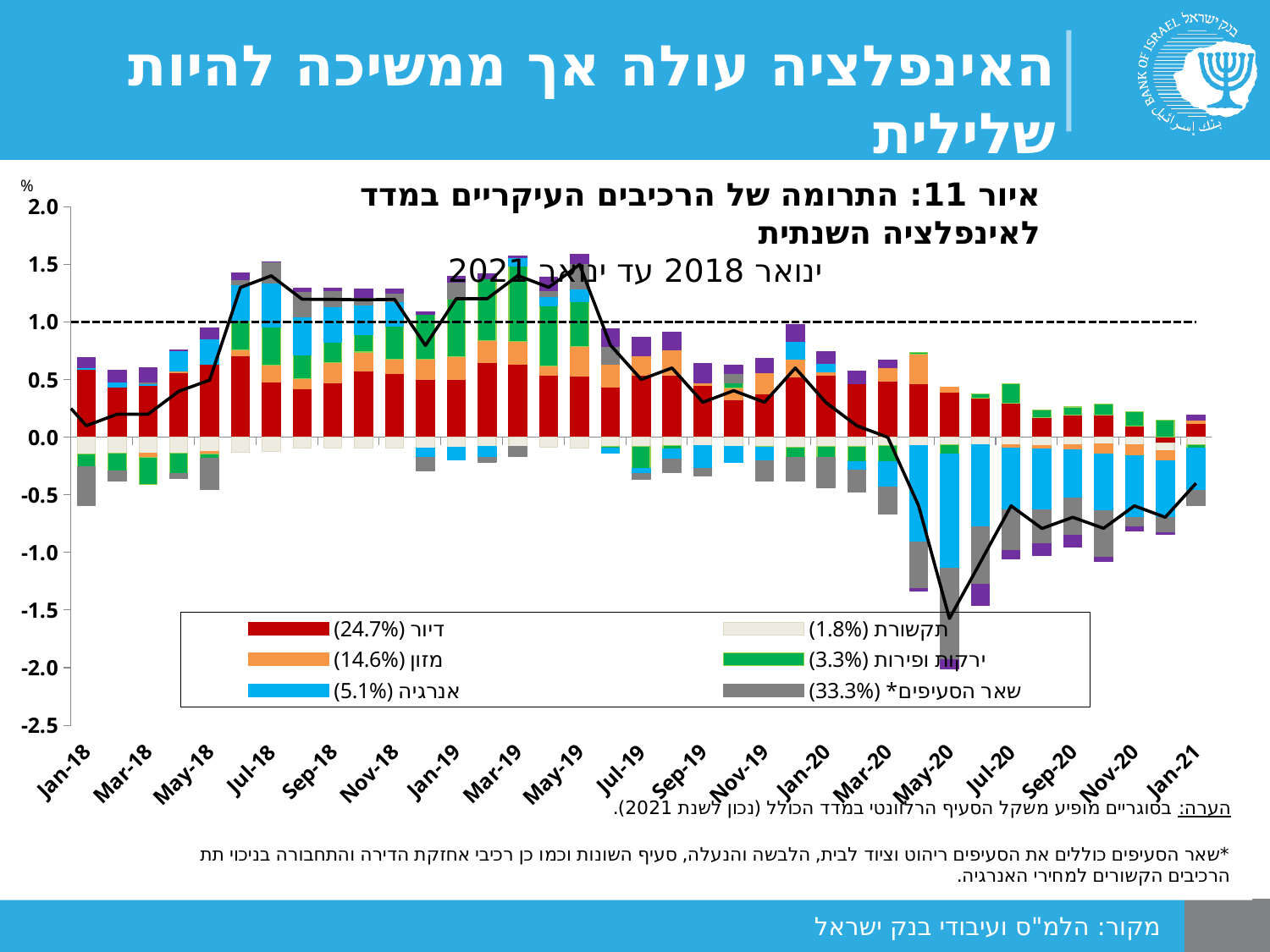
Is the value of the black line for Mar-19 greater or less than 1.0? greater Is the value of the black line for Jul-18 greater or less than 1.0? greater What weight is shown in the legend for דיור? 24.7% Is the value of the black line for Sep-20 greater or less than -0.5? less Does the black line rise or fall between May-20 and Jan-21? rise What kind of chart is shown on the slide? bar chart At what value is the horizontal dashed reference line drawn? 1.0 How many series does the legend list? 6 Does the black line rise or fall between Jul-19 and May-20? fall How many month labels are shown along the x axis? 19